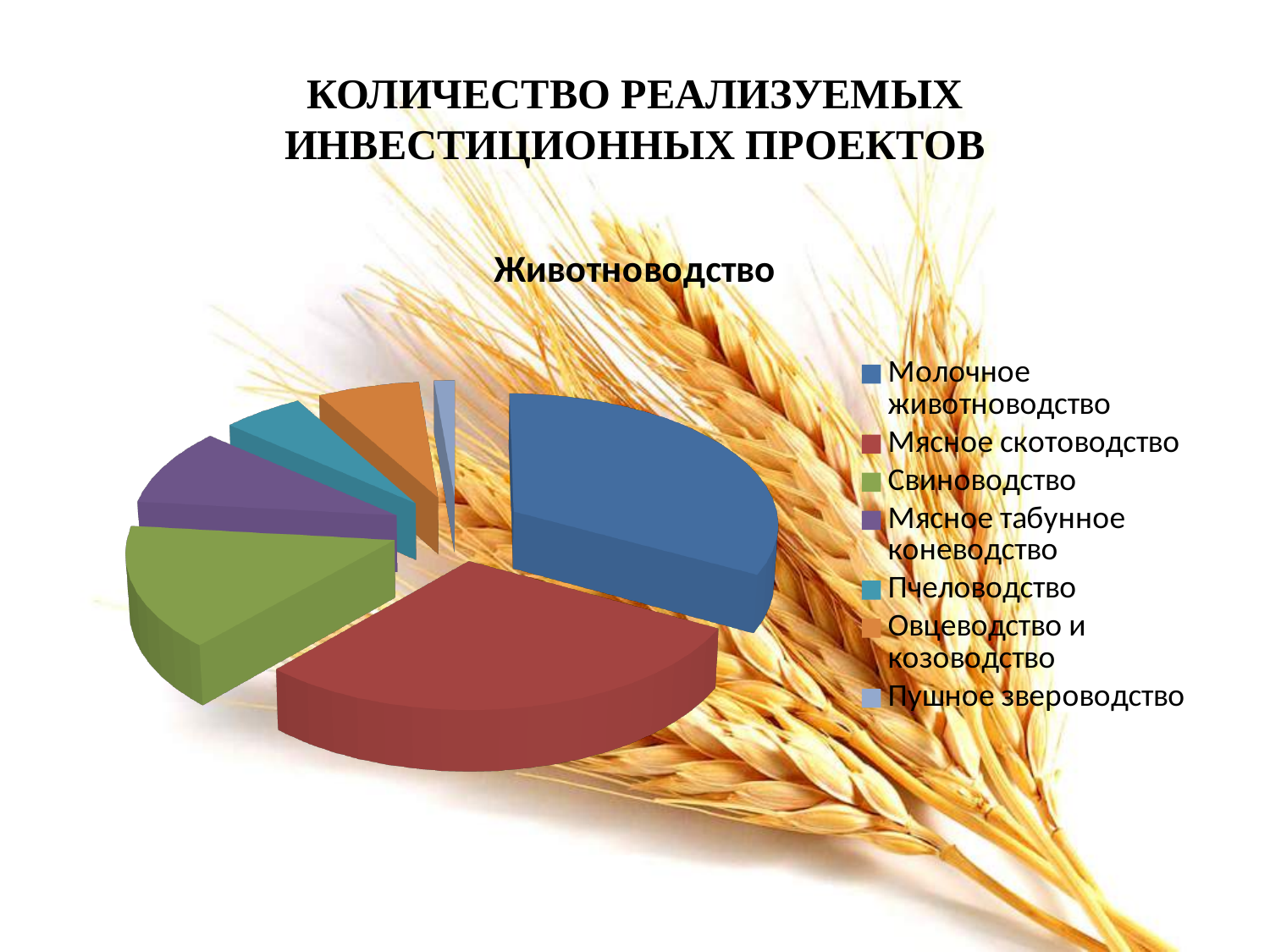
Which is larger: the slice for Мясное табунное коневодство or the slice for Пушное звероводство? Мясное табунное коневодство Which is larger: the slice for Молочное животноводство or the slice for Пчеловодство? Молочное животноводство Which category has the smallest slice of the pie? Пушное звероводство What is the title of the chart? Животноводство Which is larger: the slice for Мясное скотоводство or the slice for Овцеводство и козоводство? Мясное скотоводство What colour is the slice for Свиноводство? green How many categories does the pie chart show? 7 What kind of chart is shown on the slide? pie chart